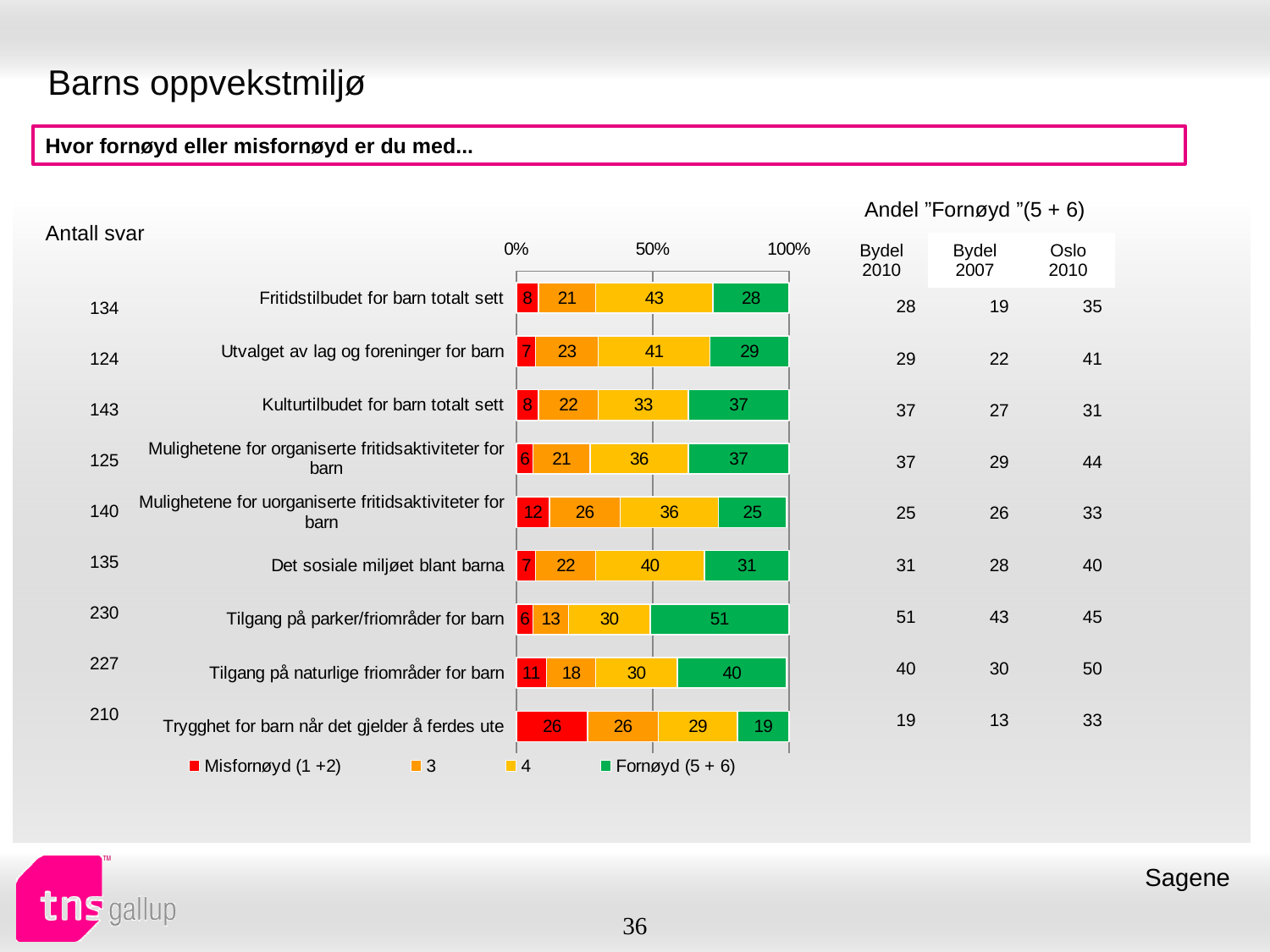
How many series does the legend list? 4 What is the value of series "4" for "Fritidstilbudet for barn totalt sett"? 43 How many categories are shown in the chart? 9 Which category has the highest "Fornøyd (5 + 6)" value? Tilgang på parker/friområder for barn What is the difference between the "Fornøyd (5 + 6)" values for "Tilgang på parker/friområder for barn" and "Tilgang på naturlige friområder for barn"? 11 What is the total of the stacked bar for "Trygghet for barn når det gjelder å ferdes ute"? 100 What is the "Misfornøyd (1 +2)" value for "Trygghet for barn når det gjelder å ferdes ute"? 26 Which category has the lowest "Fornøyd (5 + 6)" value? Trygghet for barn når det gjelder å ferdes ute Which is larger: the "Misfornøyd (1 +2)" value for "Mulighetene for uorganiserte fritidsaktiviteter for barn" or for "Mulighetene for organiserte fritidsaktiviteter for barn"? Mulighetene for uorganiserte fritidsaktiviteter for barn What is the "Fornøyd (5 + 6)" value for "Tilgang på parker/friområder for barn"? 51 What kind of chart is shown on the slide? Stacked bar chart Which series is shown in green in the chart? Fornøyd (5 + 6)